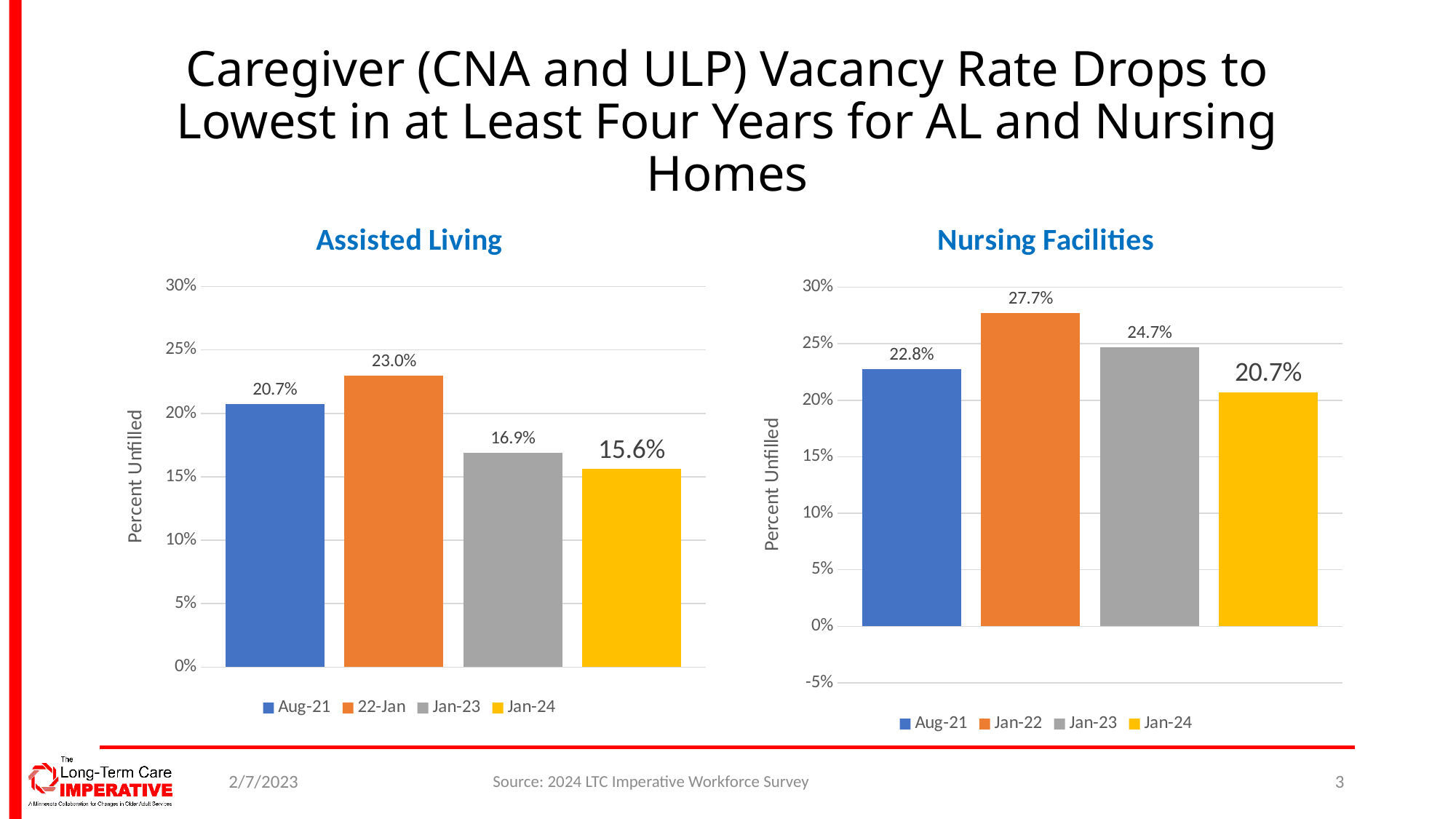
How many bars are plotted in the Nursing Facilities chart? 4 In the Nursing Facilities chart, which is larger, the Aug-21 value or the Jan-23 value? Jan-23 In the Assisted Living chart, what is the difference between the 22-Jan and Jan-23 values? 6.1% In the Nursing Facilities chart, what is the difference between the Jan-22 and Jan-24 values? 7.0% What kind of chart is the Assisted Living chart? bar chart In the Assisted Living chart, which period has the lowest value? Jan-24 In the Nursing Facilities chart, what is the value for Jan-22? 27.7% In the Assisted Living chart, what is the value for Aug-21? 20.7% In the Assisted Living chart, is the value for Jan-23 greater or less than 20%? less In the Nursing Facilities chart, which period has the highest value? Jan-22 What is the y-axis label on the Nursing Facilities chart? Percent Unfilled In the Assisted Living chart, what is the value for Jan-24? 15.6%